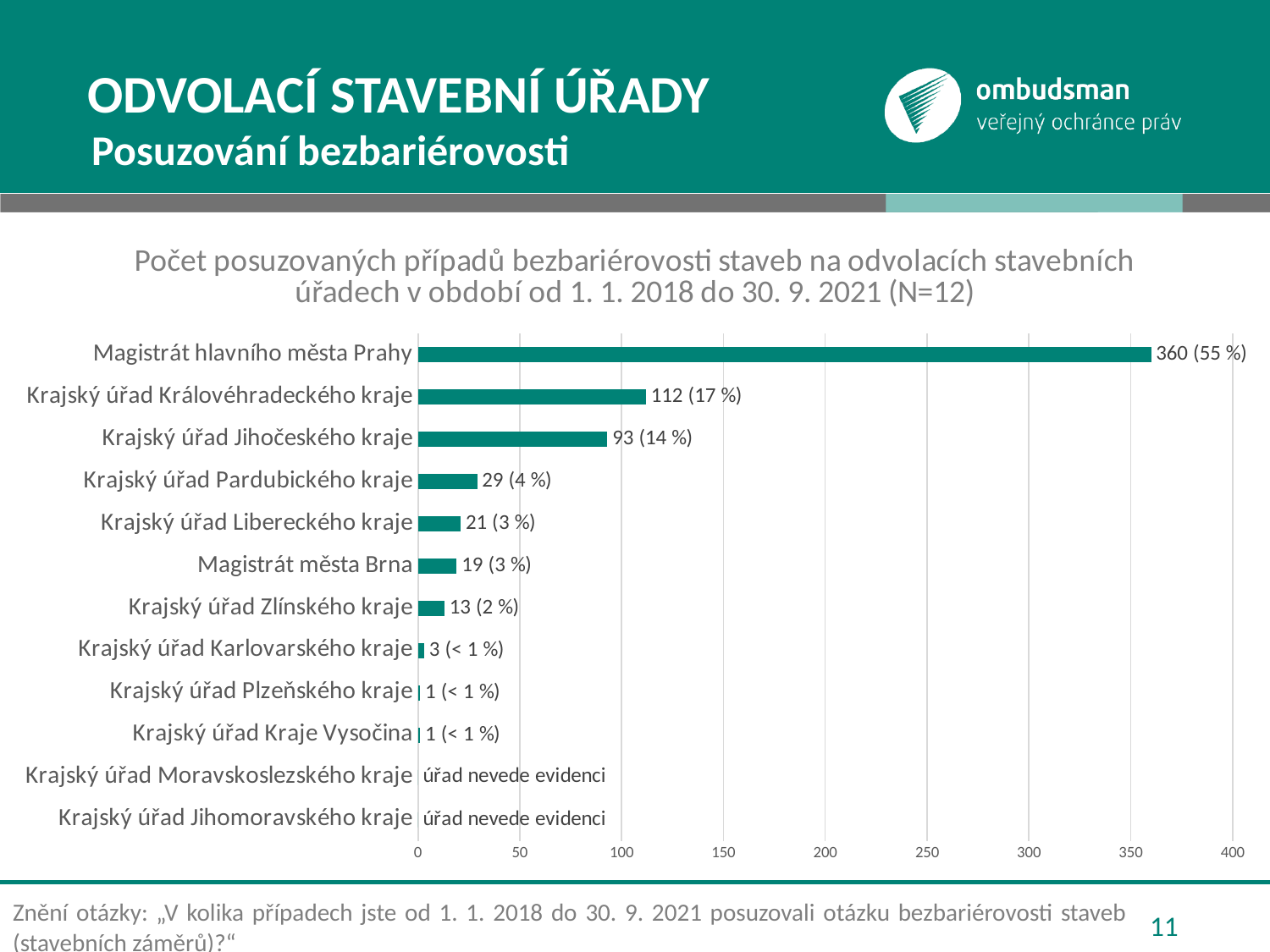
Is the value for Magistrát hlavního města Prahy greater or less than 350? greater What value is shown for Magistrát města Brna? 19 (3 %) What is the difference in the number of cases between Magistrát hlavního města Prahy and Krajský úřad Královéhradeckého kraje? 248 What value is shown for Magistrát hlavního města Prahy? 360 (55 %) What kind of chart is shown on the slide? bar chart What value is shown for Krajský úřad Královéhradeckého kraje? 112 (17 %) What is shown instead of a value for Krajský úřad Moravskoslezského kraje? úřad nevede evidenci What value is shown for Krajský úřad Jihočeského kraje? 93 (14 %) What is the N stated in the chart title? N=12 How many categories (offices) are listed on the chart? 12 Which has more cases, Krajský úřad Pardubického kraje or Krajský úřad Libereckého kraje? Krajský úřad Pardubického kraje Which office has the highest number of assessed cases? Magistrát hlavního města Prahy